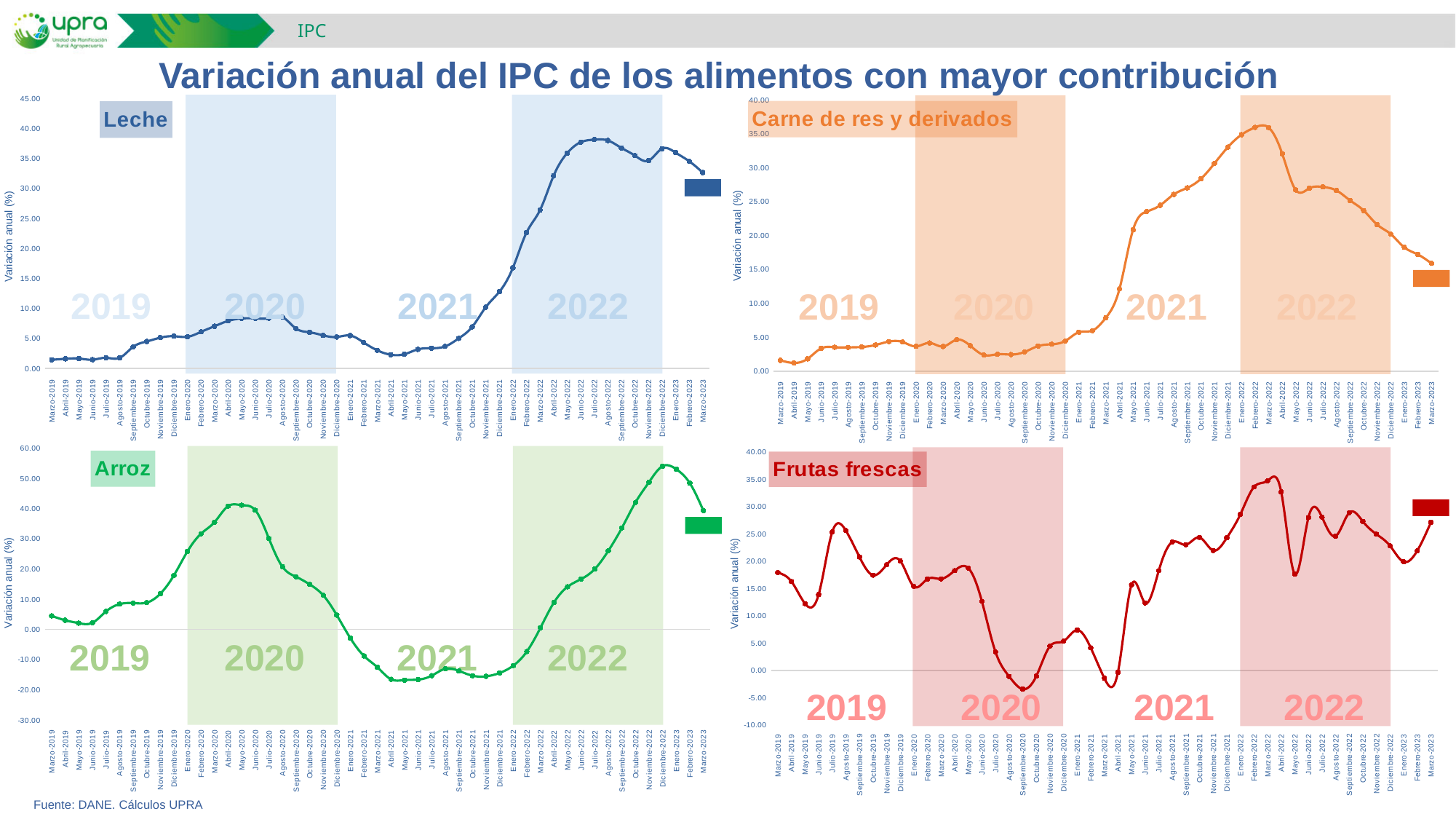
In the Leche chart, is the value for Julio-2022 greater or less than 35? greater In the Leche chart, is the value for Marzo-2019 greater or less than 5? less In the Arroz chart, which is larger, the value for Abril-2020 or the value for Enero-2023? Enero-2023 In the Carne de res y derivados chart, does the line rise or fall from Marzo-2022 to Marzo-2023? fall What kind of chart is the Leche chart? line chart In the Frutas frescas chart, is the value for Marzo-2022 greater or less than 30? greater What is the main title of the slide above the charts? Variación anual del IPC de los alimentos con mayor contribución How many charts are shown on the slide? 4